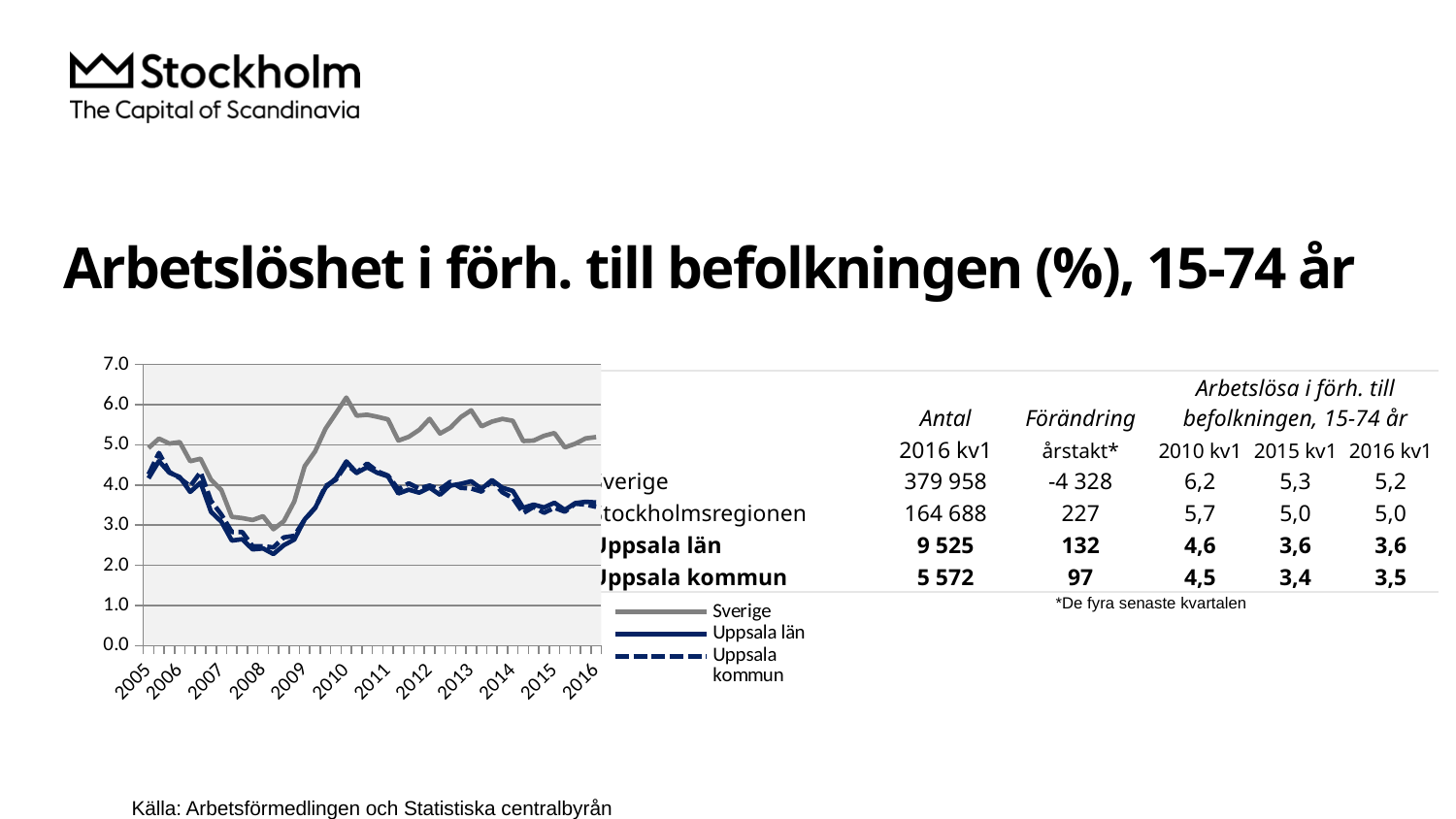
How many series does the chart's legend list? 3 What is the highest value shown on the chart's vertical axis? 7.0 How many years are labelled on the chart's horizontal axis? 12 What kind of chart is shown on the slide? line chart In the chart, is the value for Uppsala län in 2008 greater or less than 3.0? less In the chart, is the value for Uppsala län in 2016 greater or less than 4.0? less Which series has the highest values across the whole period shown in the chart? Sverige Which series is lowest at the end of the chart in 2016? Uppsala kommun Which series are listed in the chart's legend? Sverige, Uppsala län, Uppsala kommun In the chart, does the Sverige line rise or fall between 2008 and 2010? rise In the chart, which is larger in 2016: the value for Sverige or the value for Uppsala län? Sverige In the chart, is the value for Sverige in 2016 greater or less than 4.0? greater